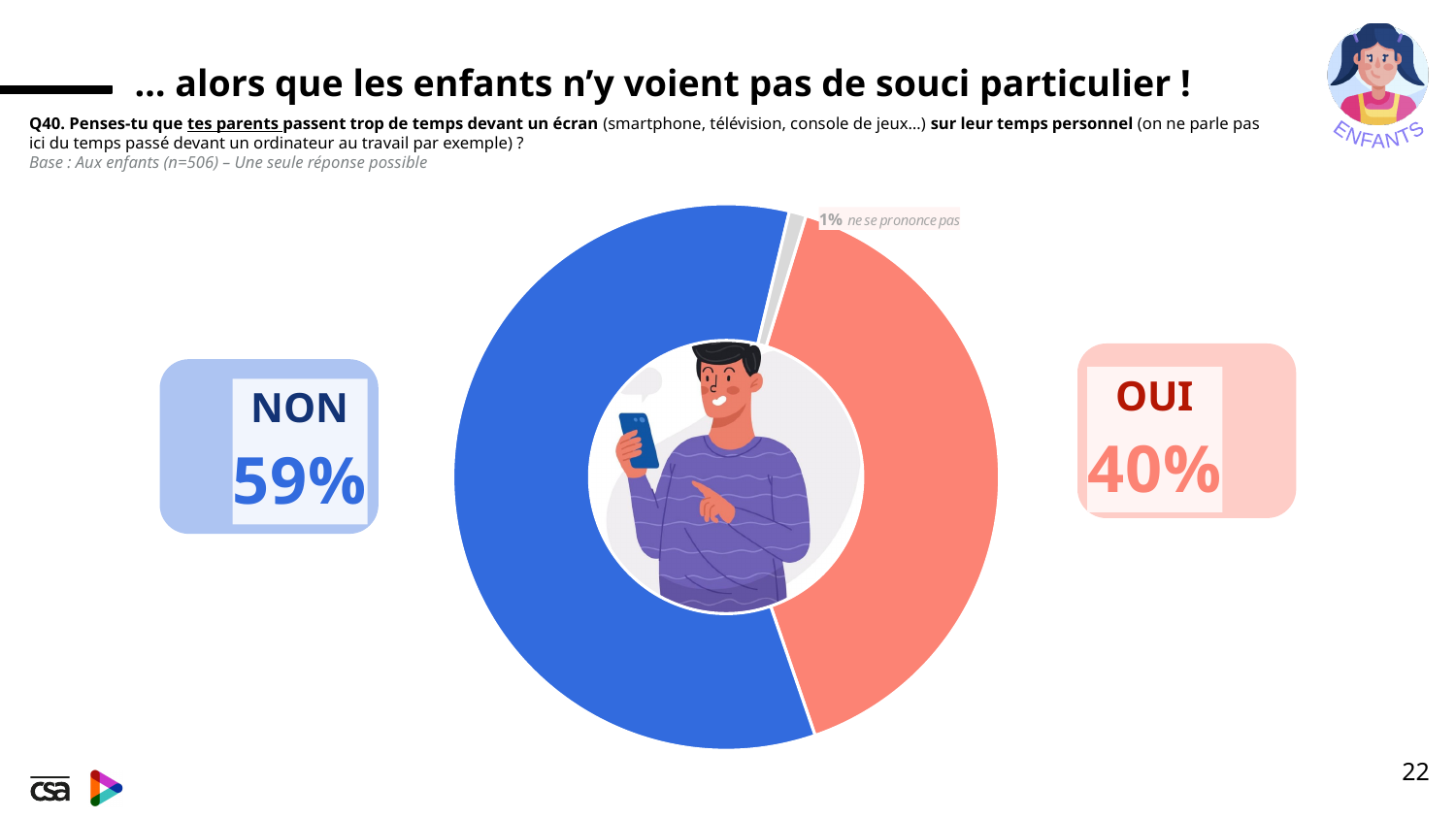
Which answer has the largest share of the pie? NON What is the difference in percentage points between NON and OUI? 19 What colour is the NON slice of the pie chart? blue Which answer has the smallest share of the pie? ne se prononce pas What kind of chart is shown on the slide? pie chart What colour is the OUI slice of the pie chart? salmon/coral (pinkish red) Which is larger, the share for OUI or the share for NON? NON How many slices does the pie chart have? 3 What share of respondents is labelled 'ne se prononce pas'? 1% What is the combined share of OUI and NON? 99% What share of children answered OUI? 40% What share of children answered NON? 59%